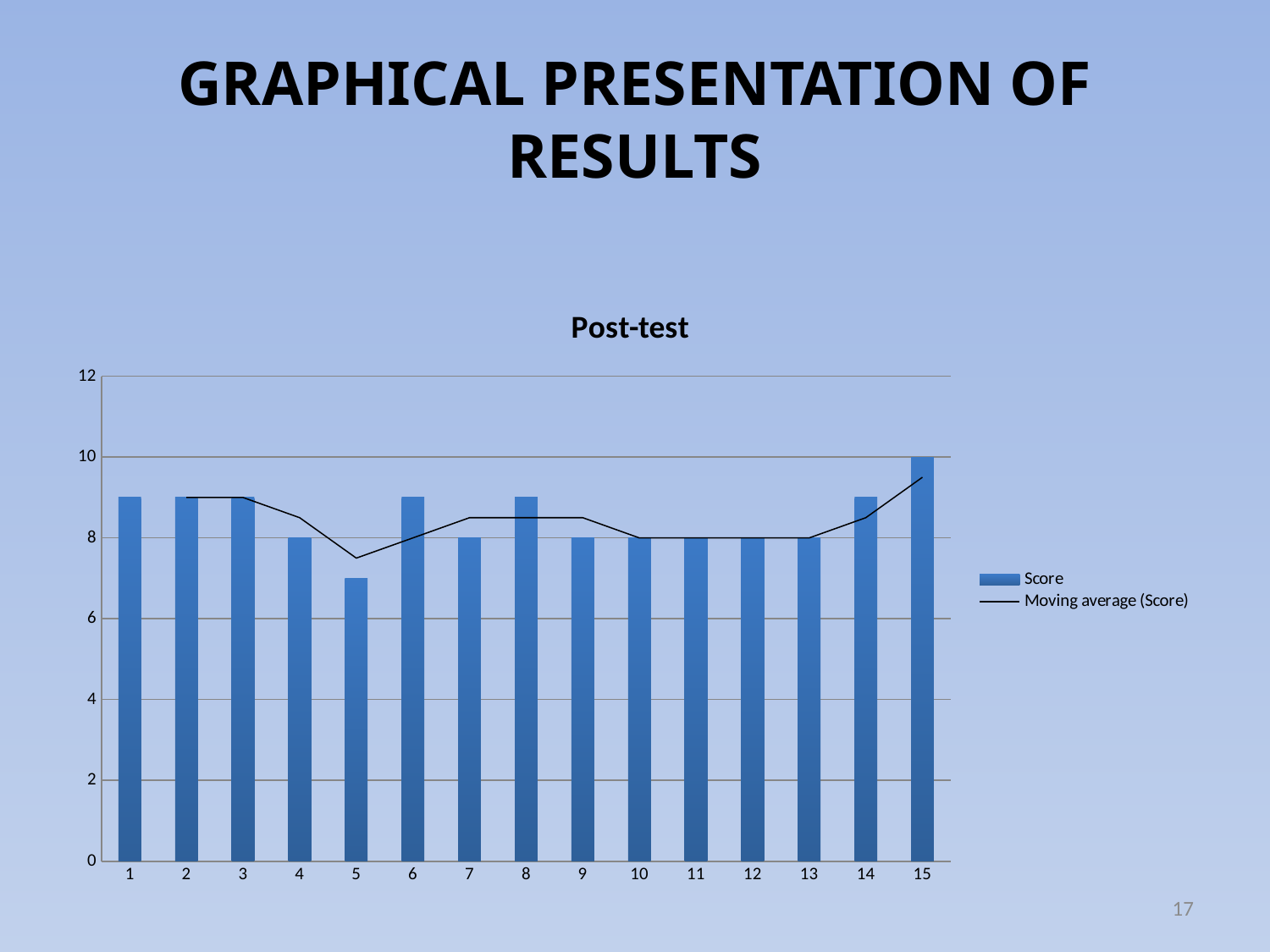
What is the name of the line series in the legend of the Post-test chart? Moving average (Score) What is the difference between the Score for category 15 and the Score for category 4? 2 What type of chart is shown under the title "Post-test"? bar chart Is the Score for category 5 greater or less than 8? less Which category has the lowest Score bar in the Post-test chart? 5 What is the Score for category 4 in the Post-test chart? 8 Which has the larger Score, category 5 or category 15? 15 How many categories are shown on the x axis of the Post-test chart? 15 What is the Score for category 15 in the Post-test chart? 10 Is the Score for category 1 greater or less than 8? greater Which category has the highest Score bar in the Post-test chart? 15 How many series does the legend of the Post-test chart list? 2